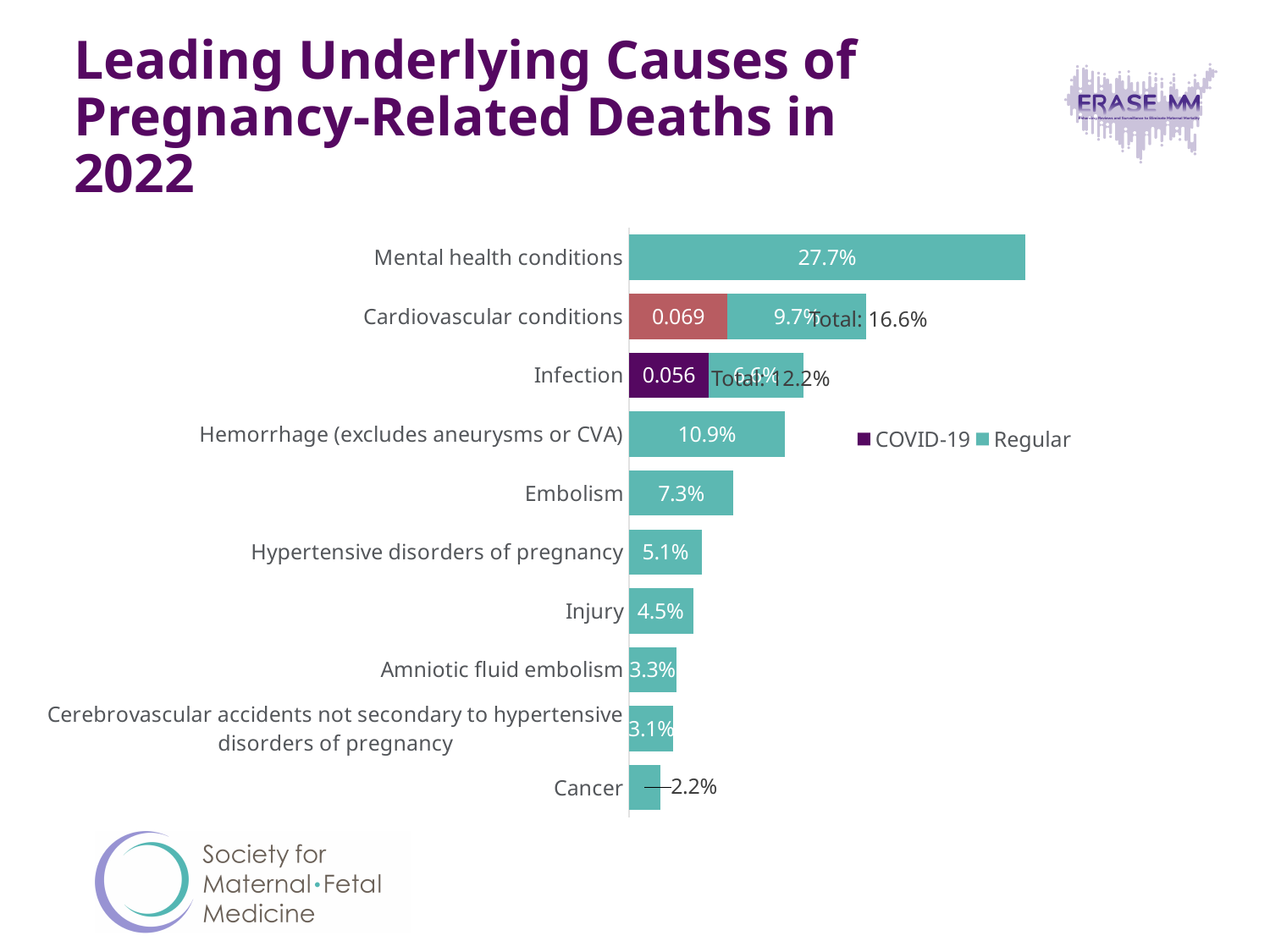
What is the value for Embolism? 7.3% What kind of chart is shown on the slide? Bar chart Which is larger, the value for Injury or the value for Hypertensive disorders of pregnancy? Hypertensive disorders of pregnancy What is the Regular value for Cardiovascular conditions? 9.7% What is the total for the Cardiovascular conditions bar? 16.6% What is the difference between the values for Mental health conditions and Hemorrhage (excludes aneurysms or CVA)? 16.8 percentage points How many categories are shown in the chart? 10 Which category has the lowest value? Cancer What is the value for Mental health conditions? 27.7% What is the value for Hemorrhage (excludes aneurysms or CVA)? 10.9% How many series does the legend list? 2 Which category has the highest value? Mental health conditions